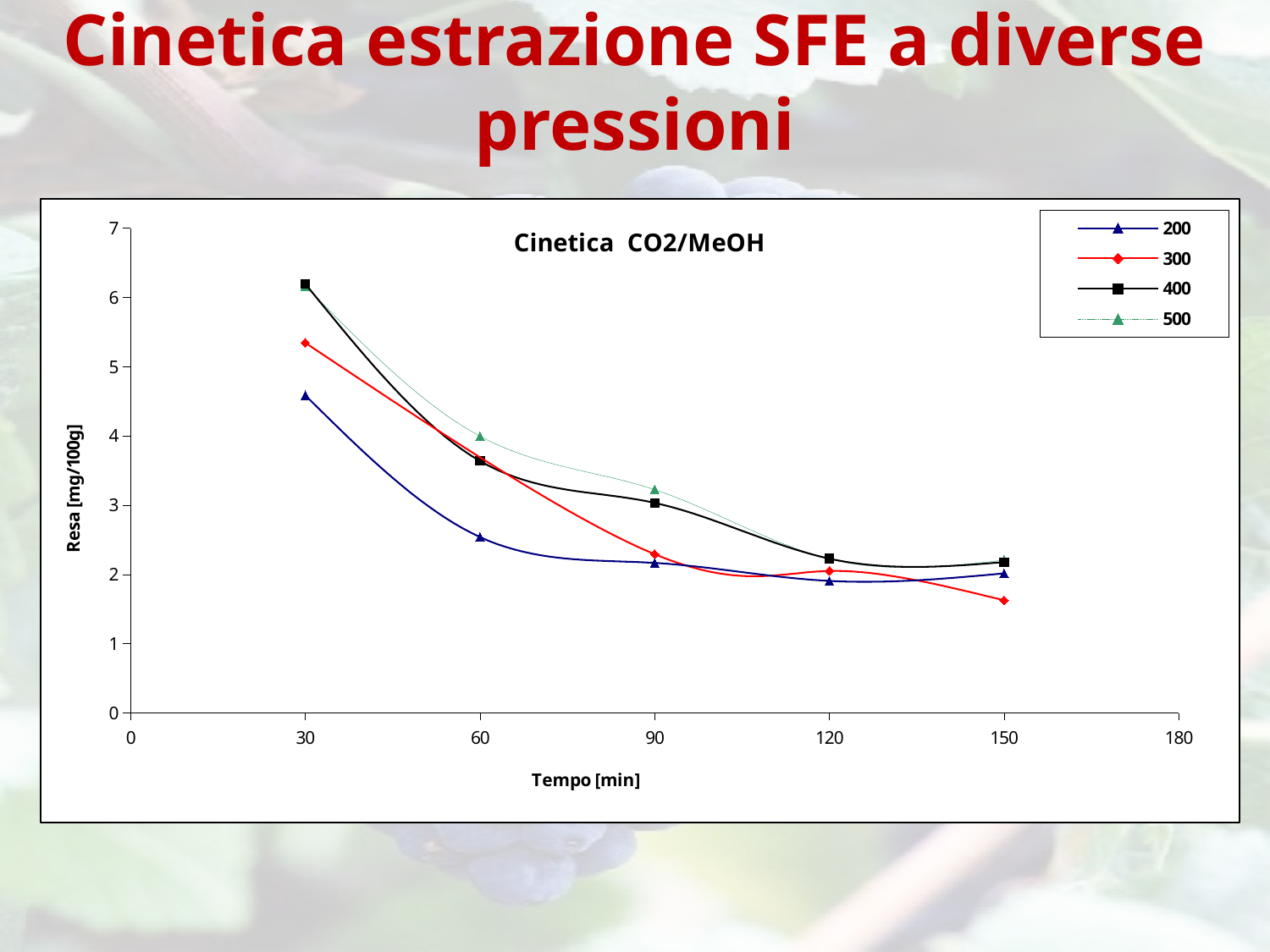
Is the value for the 300 series at 150 min greater or less than 2? less Is the value for the 200 series at 30 min greater or less than 4? greater Does the 300 series rise or fall as time increases along the x axis? fall What is the title of the chart? Cinetica CO2/MeOH At 30 min, which series has the lowest value? 200 How many time points are plotted for each series? 5 Is the value for the 500 series at 60 min greater or less than 3? greater How many series does the legend list? 4 What is the label of the x axis? Tempo [min] At 60 min, which series has the larger value, 200 or 500? 500 What kind of chart is shown on the slide? line chart